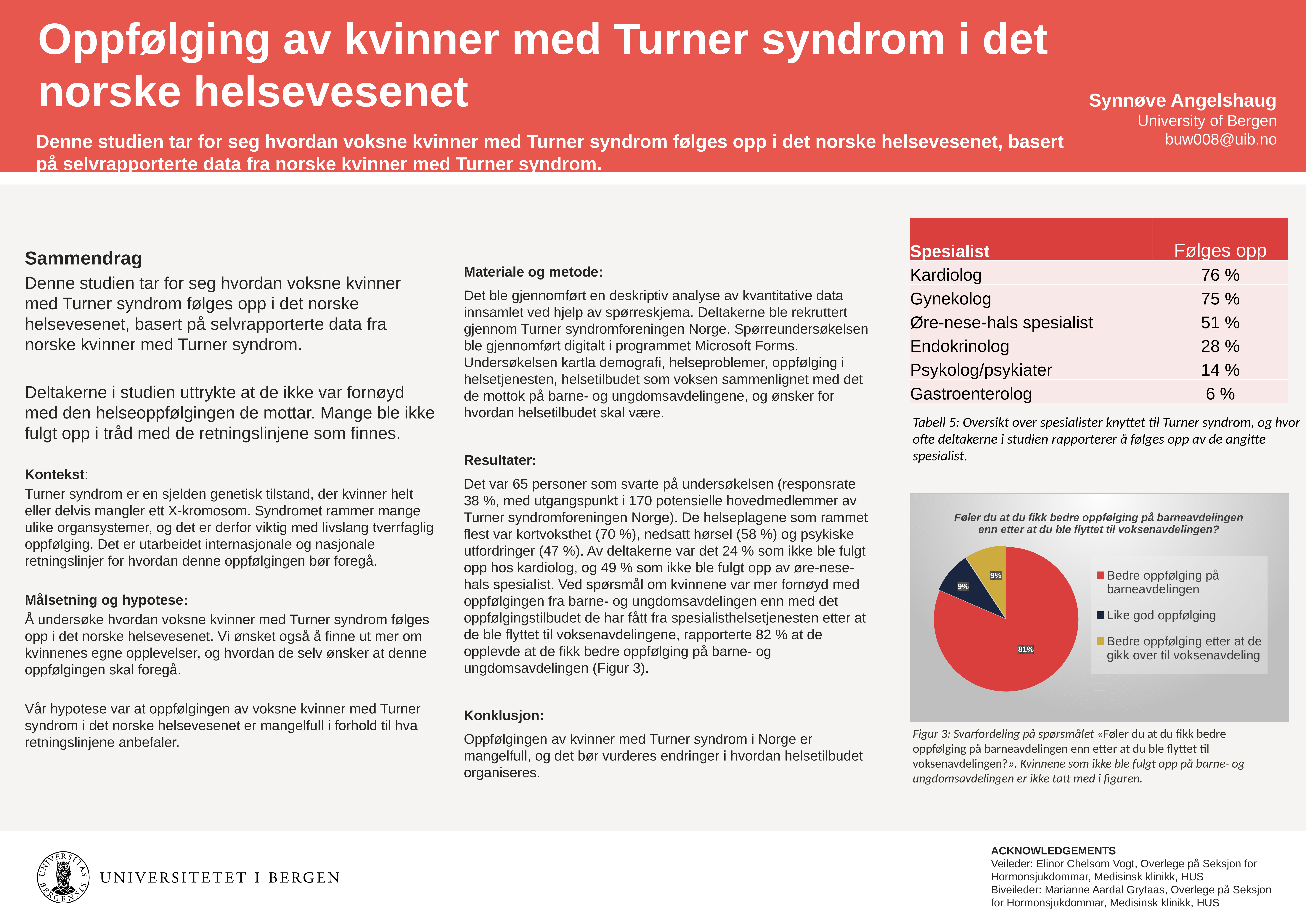
How many slices does the pie chart have? 3 Which category has the largest slice in the pie chart? Bedre oppfølging på barneavdelingen By how many percentage points does 'Bedre oppfølging på barneavdelingen' exceed 'Like god oppfølging' in the pie chart? 72 How many entries does the legend of the pie chart list? 3 What is the title of the pie chart? Føler du at du fikk bedre oppfølging på barneavdelingen enn etter at du ble flyttet til voksenavdelingen? What share of the pie chart is 'Like god oppfølging'? 9% Is the share for 'Bedre oppfølging på barneavdelingen' greater or less than 50%? greater What colour is the 'Like god oppfølging' slice in the pie chart? dark navy blue What kind of chart is shown on the slide? pie chart What share of the pie chart is 'Bedre oppfølging på barneavdelingen'? 81% Which is larger in the pie chart: 'Bedre oppfølging på barneavdelingen' or 'Like god oppfølging'? Bedre oppfølging på barneavdelingen What share of the pie chart is 'Bedre oppfølging etter at de gikk over til voksenavdeling'? 9%